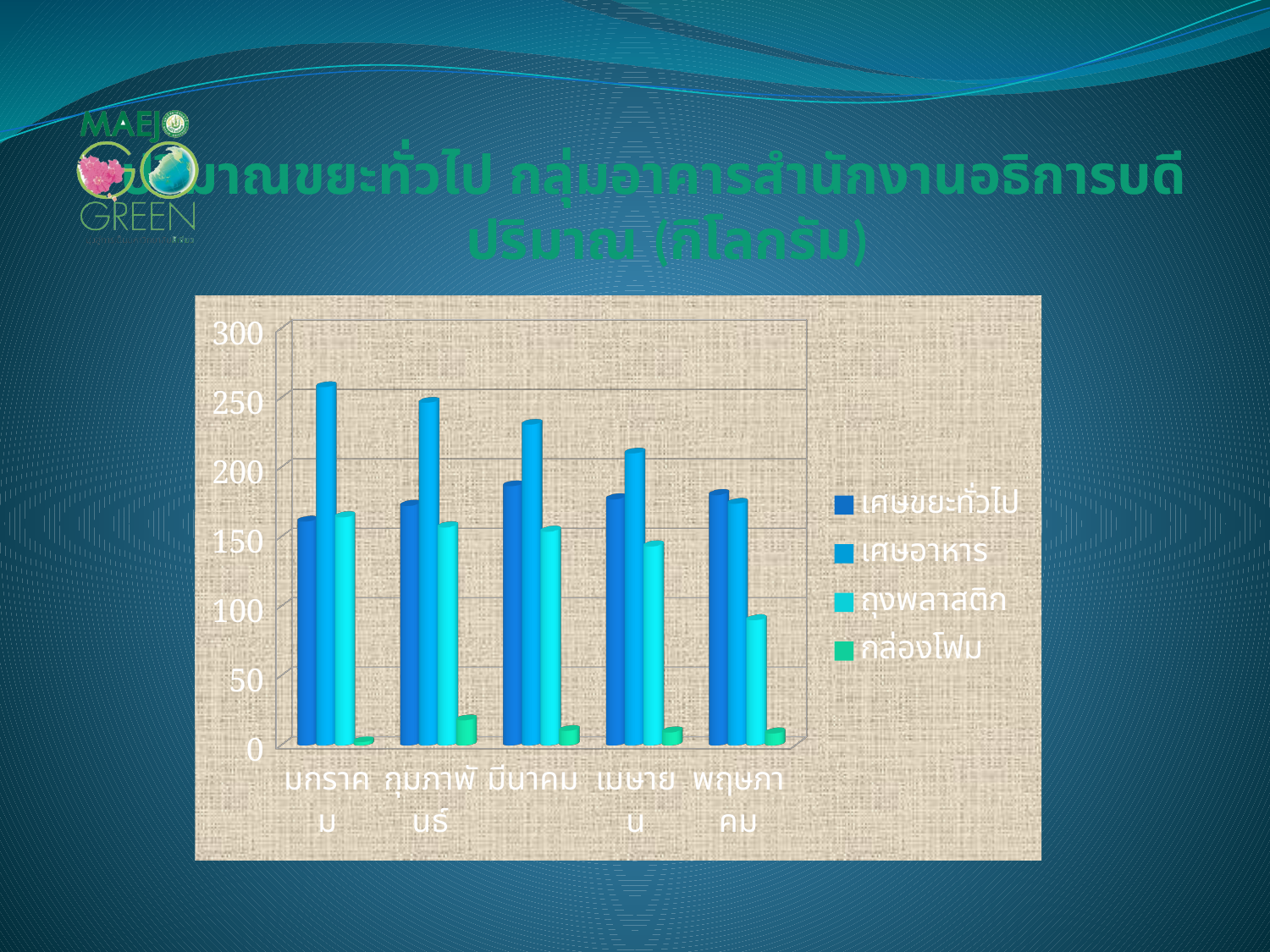
Is the value for ถุงพลาสติก in พฤษภาคม greater or less than 150? less How many series does the legend list? 4 Which series is shown in green in the legend? กล่องโฟม In มกราคม, which is larger: เศษอาหาร or เศษขยะทั่วไป? เศษอาหาร What kind of chart is shown on the slide? Bar chart Which series has the lowest value in every month? กล่องโฟม How many months (categories) are shown on the x axis? 5 In which month is the value for ถุงพลาสติก lowest? พฤษภาคม Is the value for กล่องโฟม in มกราคม greater or less than 50? less Does the value for เศษอาหาร rise or fall from มกราคม to พฤษภาคม? Falls Is the value for เศษอาหาร in มกราคม greater or less than 200? greater In which month is the value for เศษอาหาร highest? มกราคม